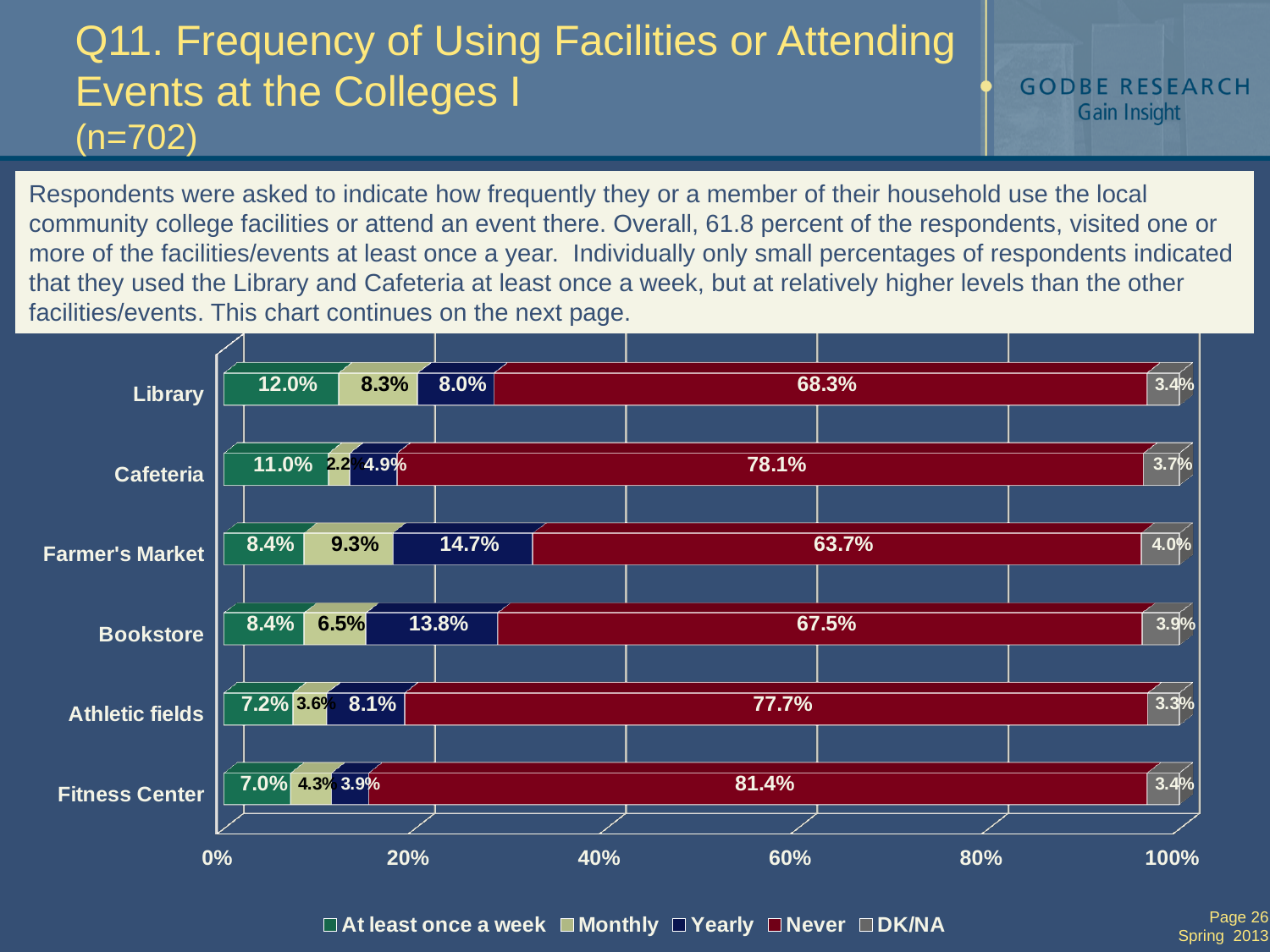
What is the total of the Library bar across all five segments? 100.0% What kind of chart is shown on the slide? Stacked bar chart What is the difference between the Never percentage for the Fitness Center and the Never percentage for the Library? 13.1 percentage points Which facility has the lowest Never percentage? Farmer's Market Which facility has the highest Never percentage? Fitness Center Which has a larger Monthly percentage, the Farmer's Market or the Bookstore? Farmer's Market Which facility has the highest 'At least once a week' percentage? Library What percentage of respondents said they never use the Library? 68.3% What is the Yearly value for the Farmer's Market? 14.7% How many facilities are shown on the chart? 6 What is the DK/NA value for the Cafeteria? 3.7% How many series does the legend list? 5